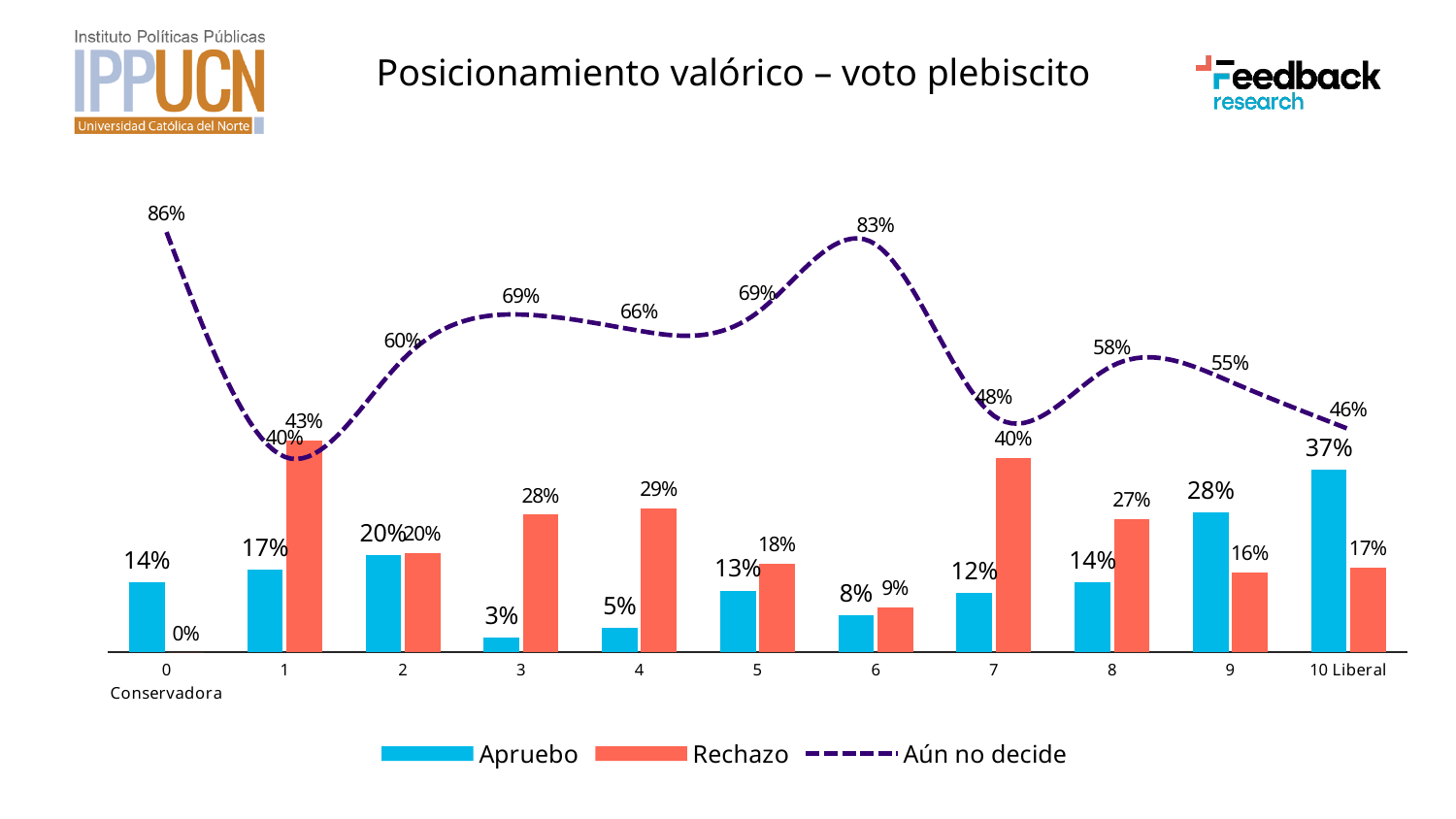
Which category has the lowest Aún no decide value? 1 How many categories are shown on the x axis? 11 What kind of chart is this? Combined bar and line chart What is the Rechazo value for category 7? 40% Which category has the lowest Apruebo value? 3 Which series is drawn as a dashed line? Aún no decide Which is larger for category 9, Apruebo or Rechazo? Apruebo Which category has the highest Rechazo value? 1 What is the Aún no decide value for category 0 Conservadora? 86% What is the difference between the Rechazo and Apruebo values for category 3? 25% What is the Apruebo value for category 10 Liberal? 37% How many series does the legend list? 3